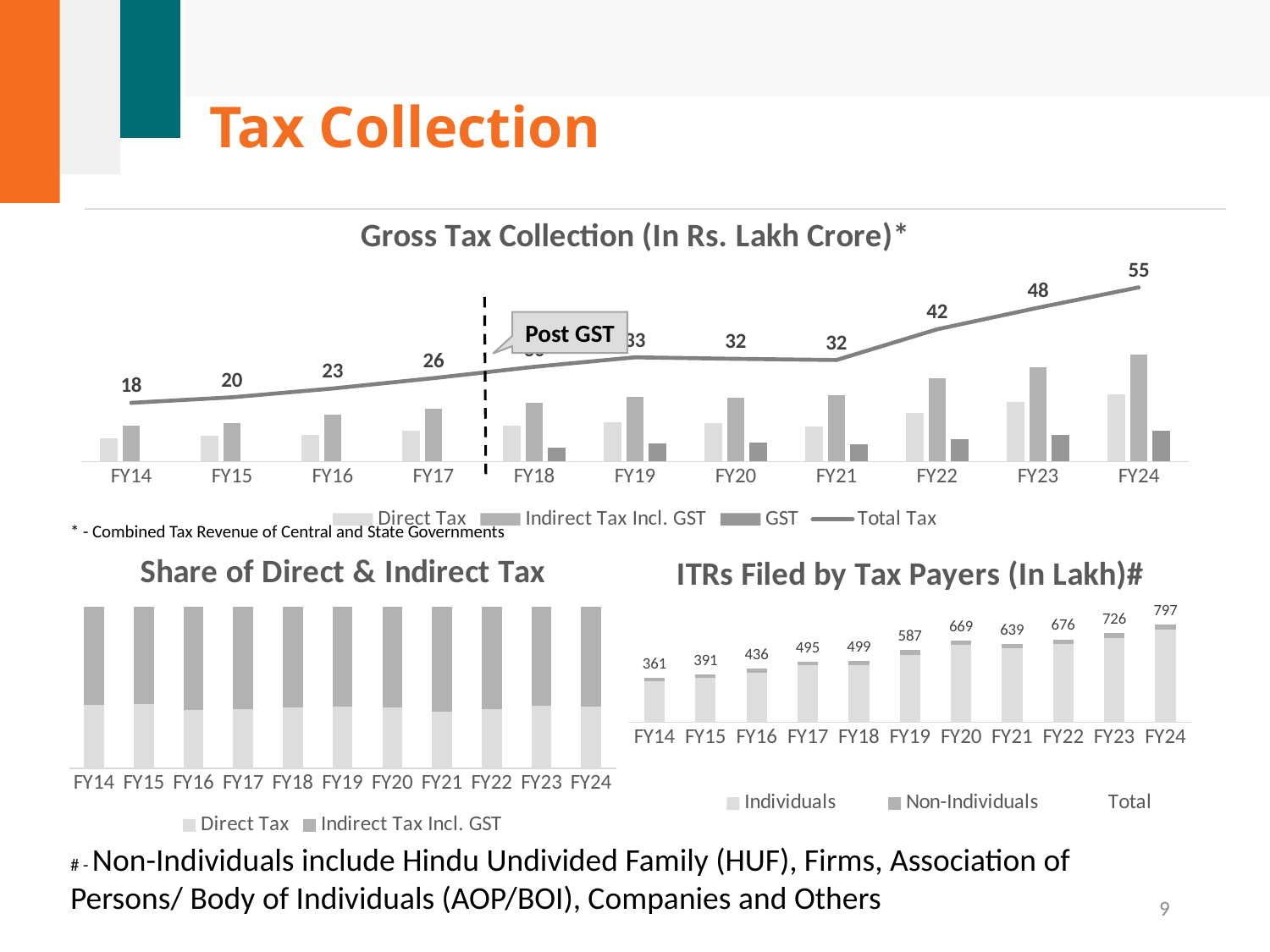
In the Gross Tax Collection chart, what is the Total Tax value for FY24? 55 In the ITRs Filed by Tax Payers chart, which is larger, the total for FY20 or FY21? FY20 In the Gross Tax Collection chart, does the Total Tax rise or fall from FY21 to FY24? rise In the Gross Tax Collection chart, what is the Total Tax value for FY14? 18 In the ITRs Filed by Tax Payers chart, what is the difference between the totals for FY24 and FY14? 436 What kind of chart is the Share of Direct & Indirect Tax chart? stacked bar chart How many fiscal years are shown on the x axis of the Gross Tax Collection chart? 11 In the ITRs Filed by Tax Payers chart, which fiscal year has the lowest total? FY14 In the ITRs Filed by Tax Payers chart, what is the total for FY24? 797 How many entries does the legend of the Gross Tax Collection chart list? 4 In the Gross Tax Collection chart, what is the difference between the Total Tax for FY24 and FY23? 7 In the Gross Tax Collection chart, which fiscal year has the highest Total Tax? FY24